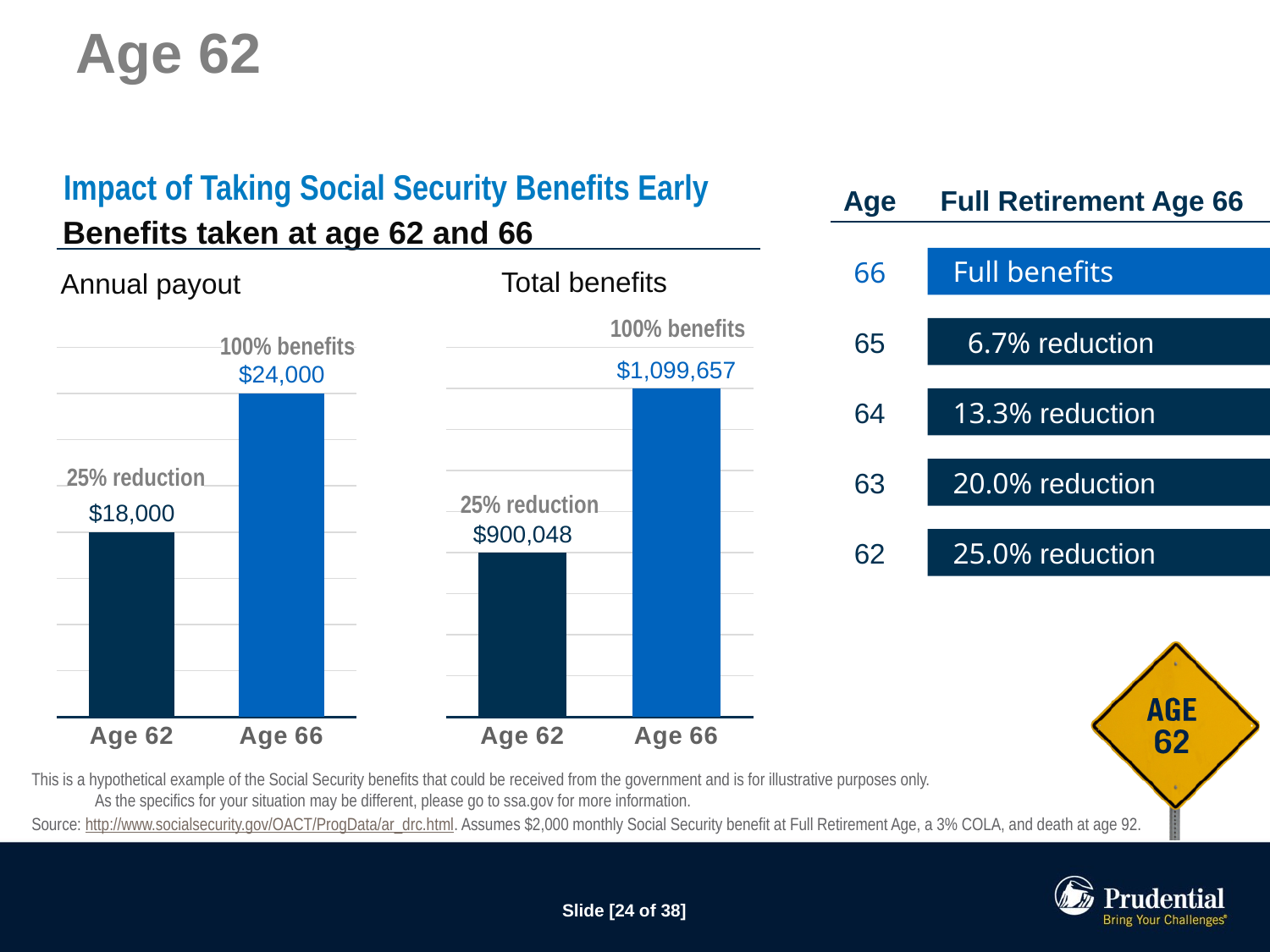
How many categories are shown in the Annual payout chart? 2 In the Total benefits chart, is the value for Age 62 larger or smaller than the value for Age 66? smaller In the Annual payout chart, what percentage reduction is labelled on the Age 62 bar? 25% reduction In the Annual payout chart, what is the value for Age 62? $18,000 In the Total benefits chart, what is the value for Age 66? $1,099,657 In the Annual payout chart, which category has the higher value? Age 66 In the Annual payout chart, what is the difference between the Age 66 and Age 62 values? $6,000 In the Total benefits chart, what is the value for Age 62? $900,048 In the Annual payout chart, what is the value for Age 66? $24,000 What kind of chart is the Total benefits chart? bar chart In the Total benefits chart, what is the difference between the Age 66 and Age 62 values? $199,609 In the Total benefits chart, which category has the lower value? Age 62